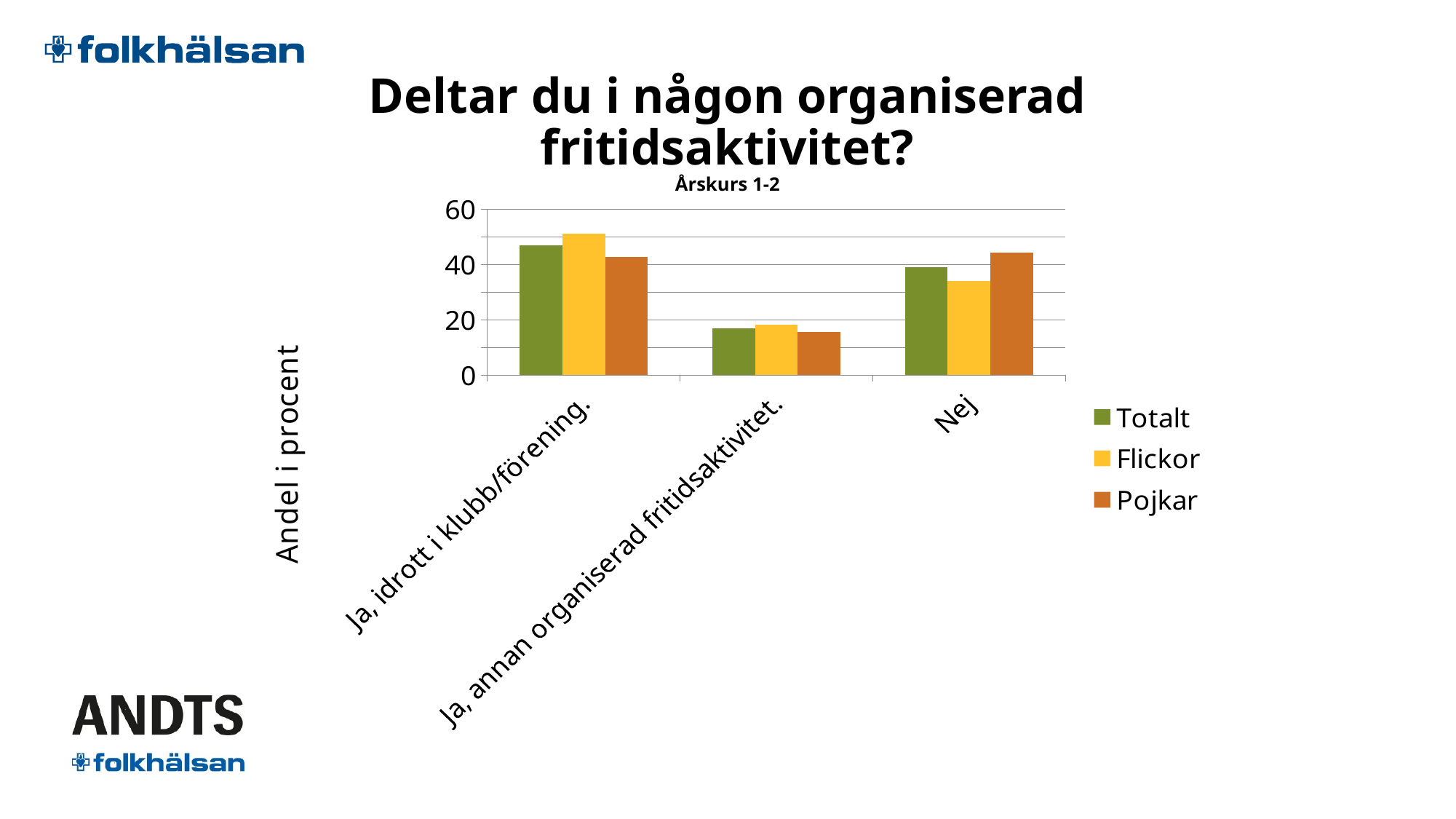
Is the value for Flickor in the category Ja, idrott i klubb/förening. greater or less than 40? greater Is the value for Totalt in the category Ja, annan organiserad fritidsaktivitet. greater or less than 20? less For the category Ja, idrott i klubb/förening., which series has the higher value, Flickor or Pojkar? Flickor For the category Nej, which series has the higher value, Flickor or Pojkar? Pojkar What kind of chart is shown on the slide? bar chart How many categories are shown on the x axis? 3 Which category has the lowest value for Pojkar? Ja, annan organiserad fritidsaktivitet. Which category has the highest value for Flickor? Ja, idrott i klubb/förening. Is the value for Pojkar in the category Nej greater or less than 40? greater What is the subtitle shown directly above the chart? Årskurs 1-2 What is the label on the vertical axis? Andel i procent How many series does the legend list? 3